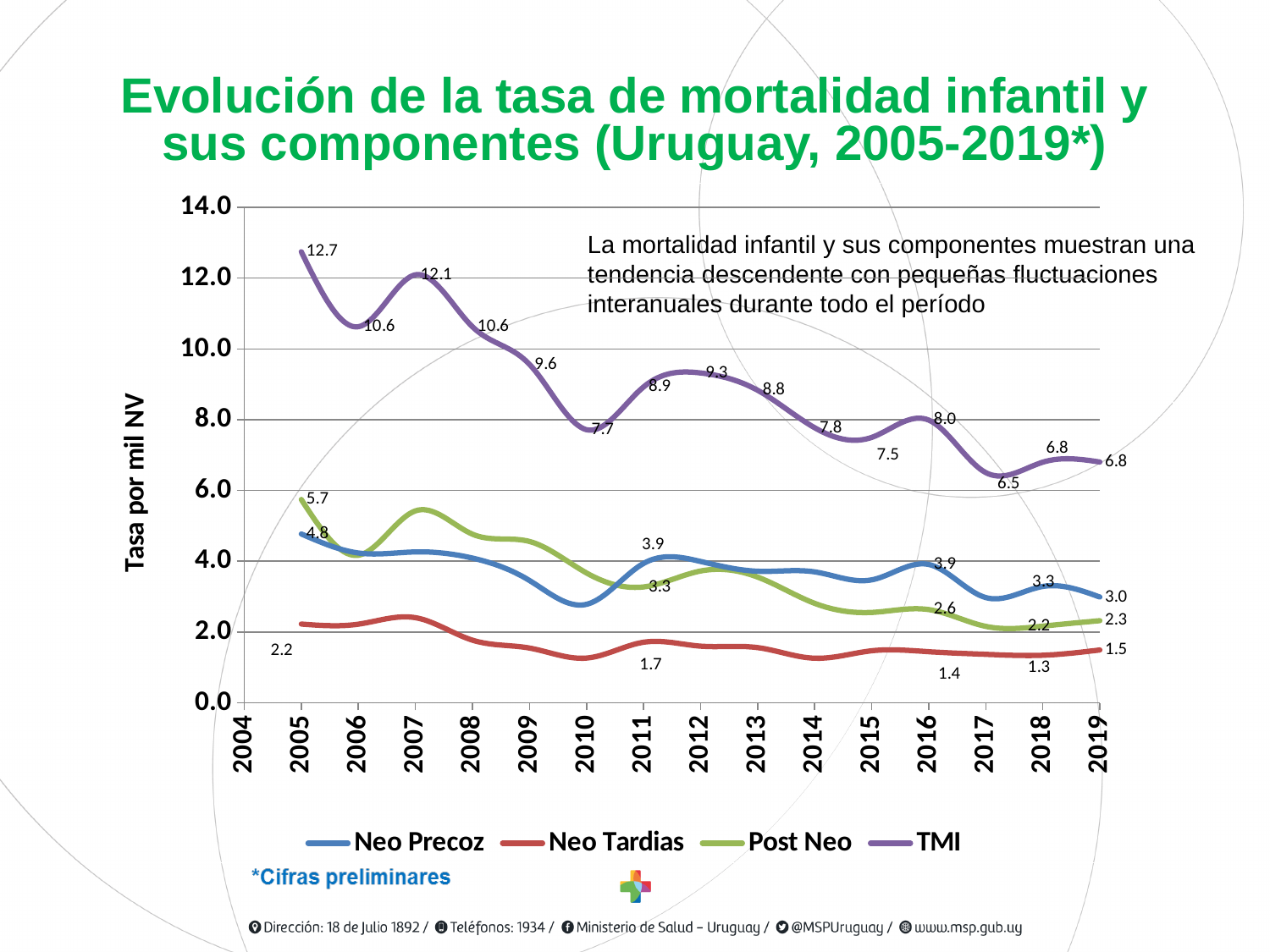
Does the TMI series generally rise or fall from 2005 to 2019? fall Is the Post Neo value for 2007 greater or less than 4.0? greater What kind of chart is shown on the slide? line chart How many series does the legend list? 4 What is the Neo Tardias value for 2019? 1.5 In which year is the TMI series at its highest? 2005 What is the title of the vertical axis? Tasa por mil NV What is the difference between the TMI value in 2005 and in 2019? 5.9 In 2019, which is larger: Neo Precoz or Post Neo? Neo Precoz In which year is the TMI series at its lowest? 2017 What is the Post Neo value for 2005? 5.7 What is the TMI value for 2005? 12.7